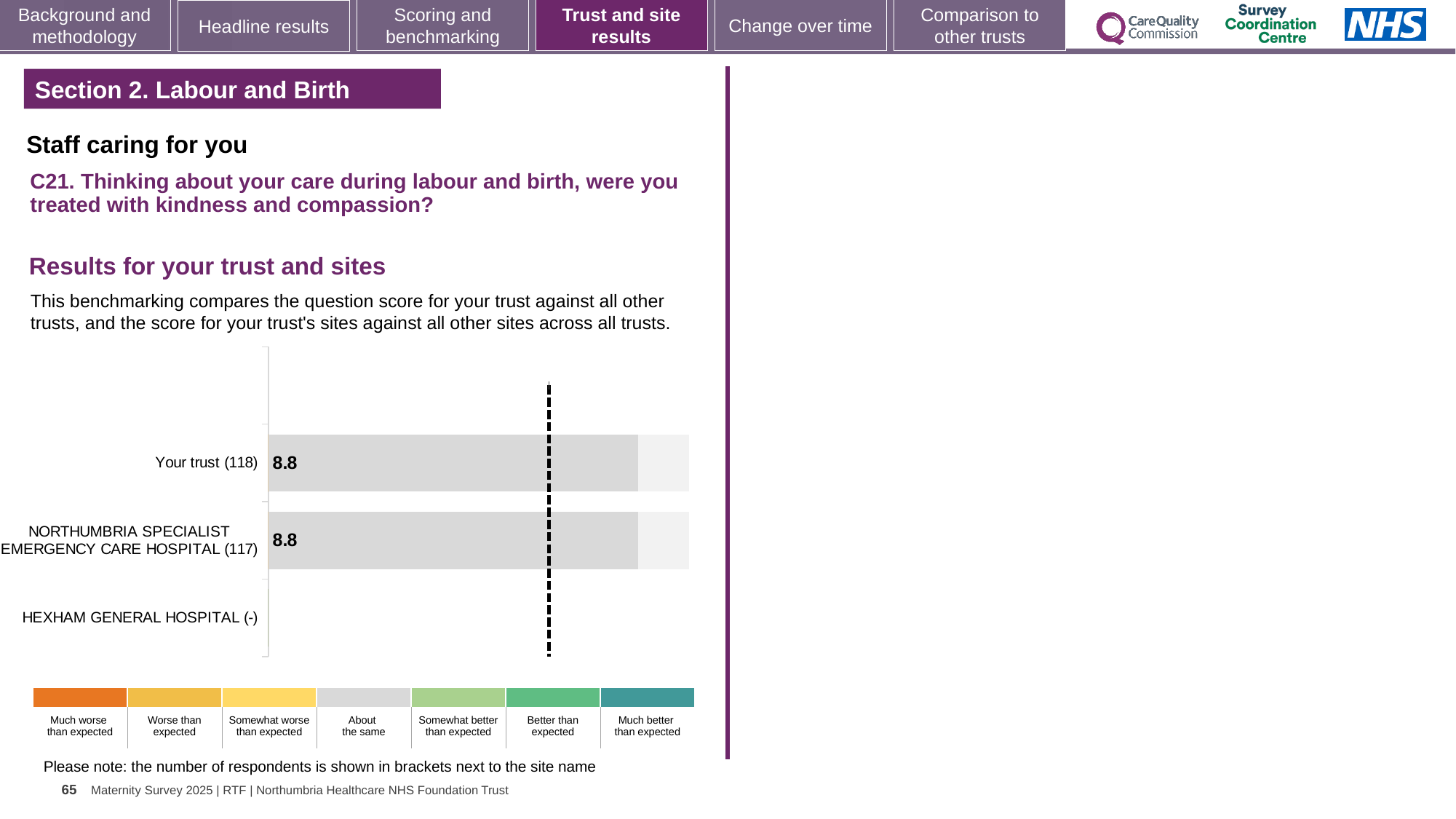
What is the score shown for NORTHUMBRIA SPECIALIST EMERGENCY CARE HOSPITAL (117)? 8.8 How many categories are listed on the vertical axis of the chart? 3 What is the difference between the score for Your trust (118) and the score for NORTHUMBRIA SPECIALIST EMERGENCY CARE HOSPITAL (117)? 0 Is the score for Your trust larger than, smaller than, or equal to the score for NORTHUMBRIA SPECIALIST EMERGENCY CARE HOSPITAL? Equal What is the score shown for Your trust (118)? 8.8 Which category on the chart has no bar plotted? HEXHAM GENERAL HOSPITAL (-) How many benchmark categories does the colour legend below the chart list? 7 How many respondents are shown in brackets for NORTHUMBRIA SPECIALIST EMERGENCY CARE HOSPITAL? 117 How many respondents are shown in brackets for Your trust? 118 What kind of chart is shown on the slide? Bar chart According to the colour legend, which benchmark category does the grey colour of the plotted bars represent? About the same